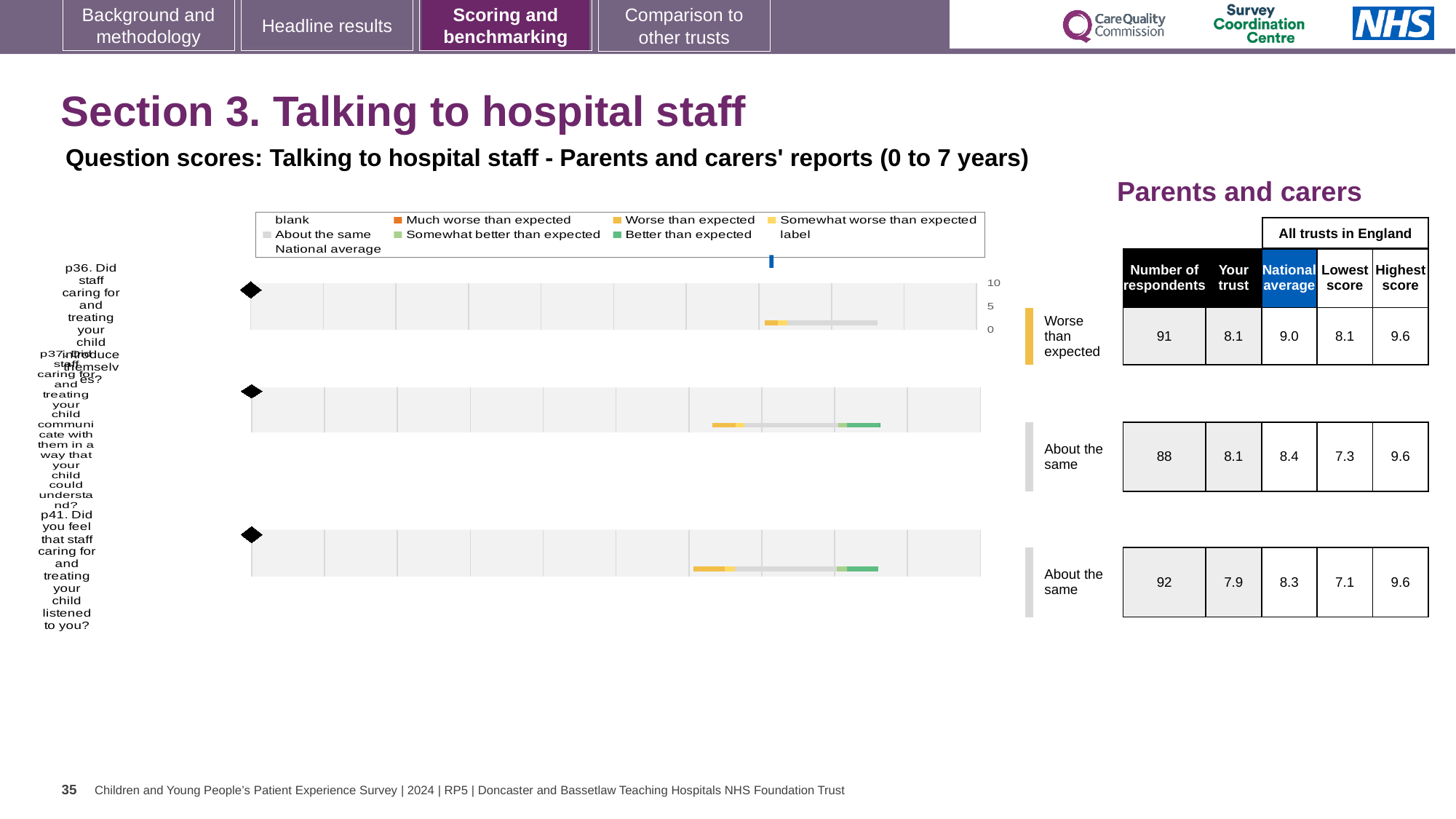
Which colour in the legend represents 'Better than expected'? green How many respondents answered p37? 88 For p36, which is larger: the trust's score or the national average? National average What is the national average score for p41 (Did you feel that staff caring for and treating your child listened to you)? 8.3 Which question is rated 'Worse than expected' for this trust? p36 How many survey questions are plotted in the chart? 3 Which question has the lowest 'Lowest score' across all trusts in England? p41 Which question has the most respondents? p41 What is the maximum value shown on the chart's score axis? 10 What is the difference between the national average and the trust's score for p36? 0.9 What is the 'Your trust' score for p36 (Did staff caring for and treating your child introduce themselves)? 8.1 What kind of chart is used to show the question scores on this slide? bar chart